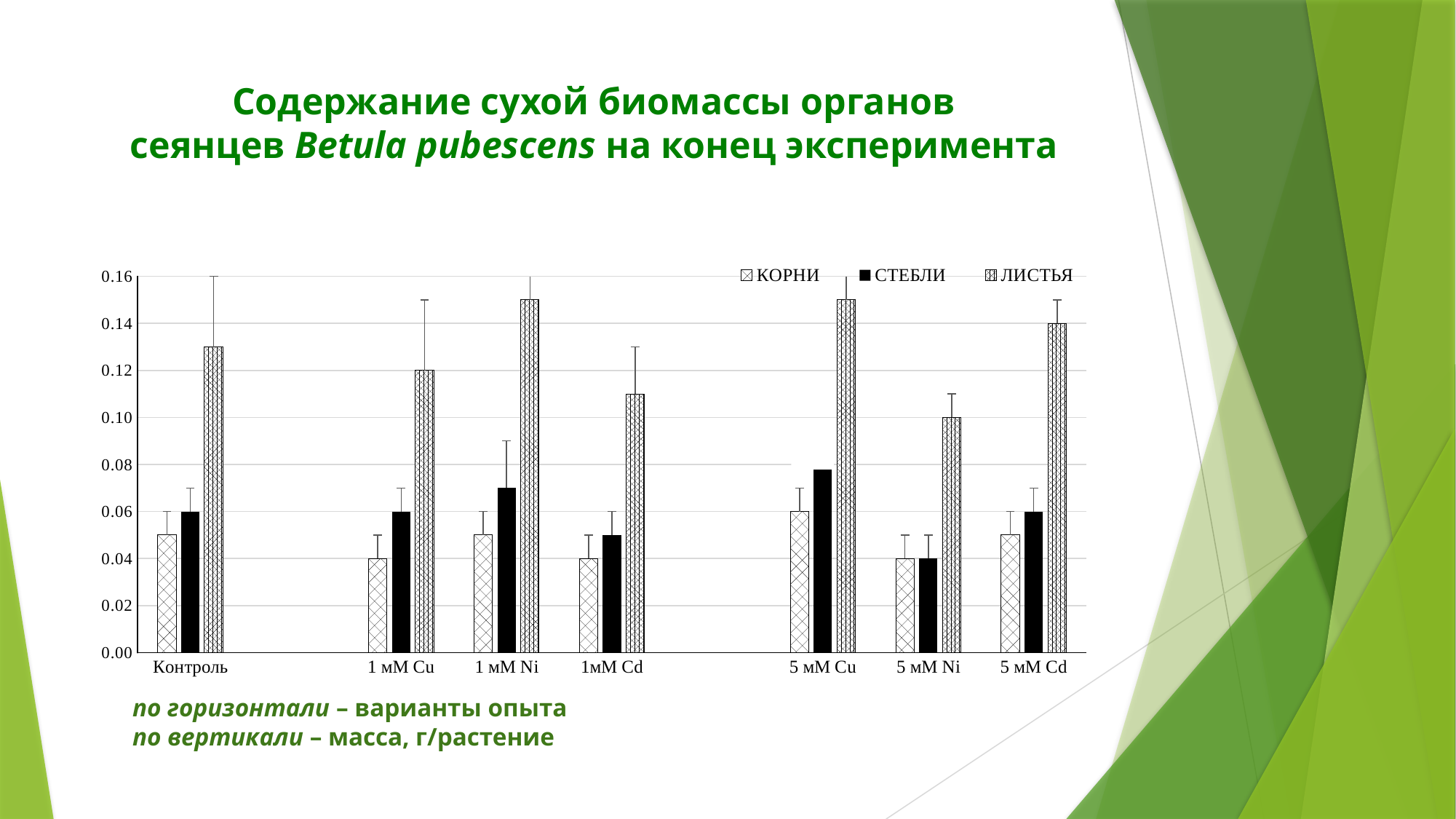
What kind of chart is shown on the slide? bar chart What is the value for ЛИСТЬЯ at 5 мМ Ni? 0.10 Which is larger: the СТЕБЛИ value for 1 мМ Ni or for 5 мМ Ni? 1 мМ Ni Which series does the solid black bar represent? СТЕБЛИ Which variant has the lowest value for ЛИСТЬЯ? 5 мМ Ni Which is larger: the ЛИСТЬЯ value for Контроль or for 1мМ Cd? Контроль How many series does the legend list? 3 Is the value for СТЕБЛИ at 1мМ Cd greater or less than 0.06? less How many experimental variants (categories) are shown on the x axis? 7 What is the value for КОРНИ at 5 мМ Cu? 0.06 Is the value for ЛИСТЬЯ at 1 мМ Ni greater or less than 0.14? greater What is the value for ЛИСТЬЯ at 1 мМ Cu? 0.12